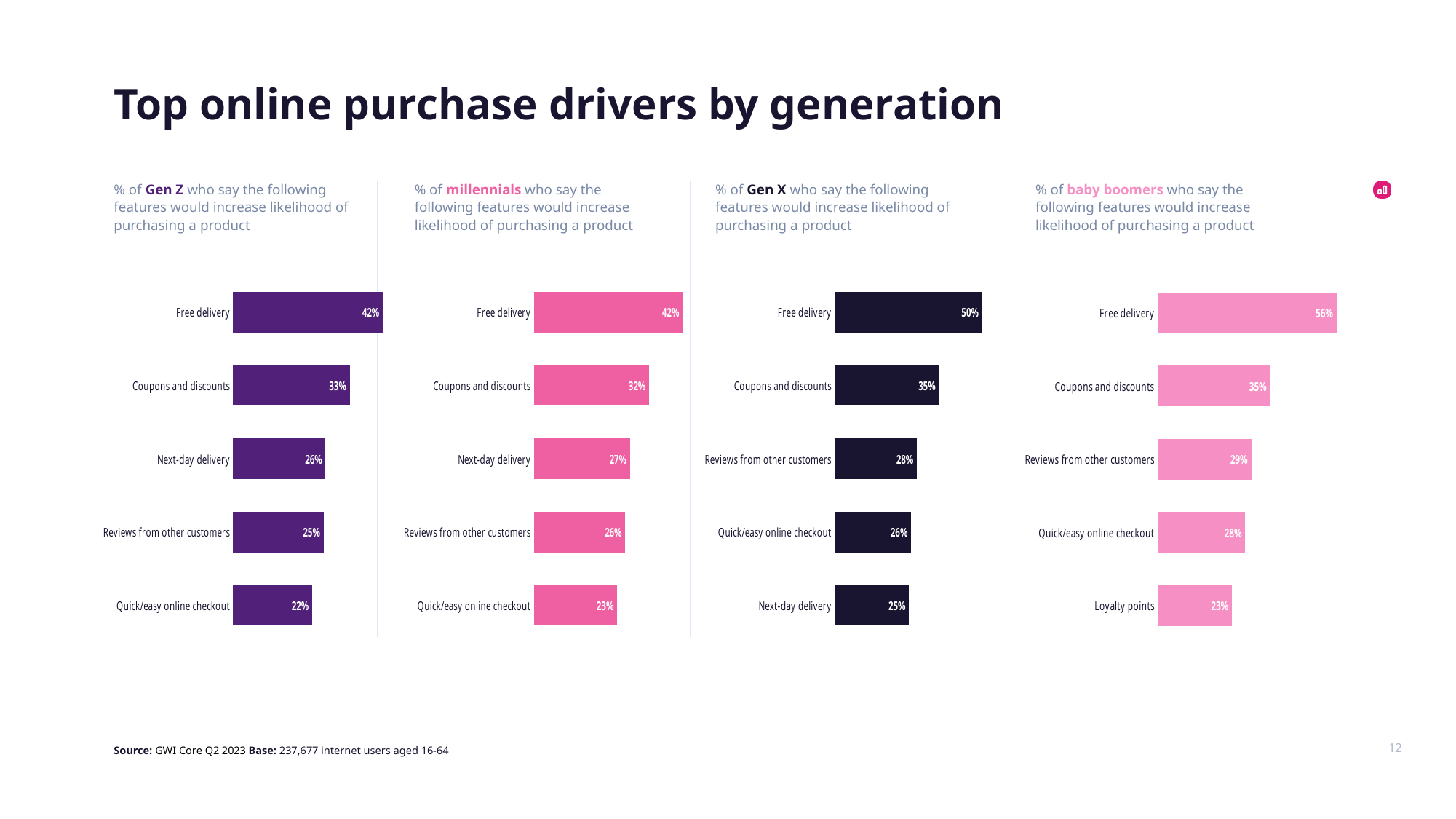
In the Gen X chart, what is the difference between free delivery and coupons and discounts? 15 percentage points In the Gen Z chart, what percentage say free delivery would increase likelihood of purchasing a product? 42% In the baby boomers chart, what is the value for loyalty points? 23% What type of chart is used for the Gen Z data? Bar chart In the Gen X chart, which feature has the lowest value? Next-day delivery How many features are shown in the millennials chart? 5 Which is larger: free delivery for Gen X or free delivery for baby boomers? Baby boomers In the millennials chart, what is the value for coupons and discounts? 32% In the Gen X chart, what is the value for reviews from other customers? 28% In the Gen Z chart, what is the difference between free delivery and quick/easy online checkout? 20 percentage points In the baby boomers chart, which feature has the highest value? Free delivery How many generation charts are shown on the slide? 4